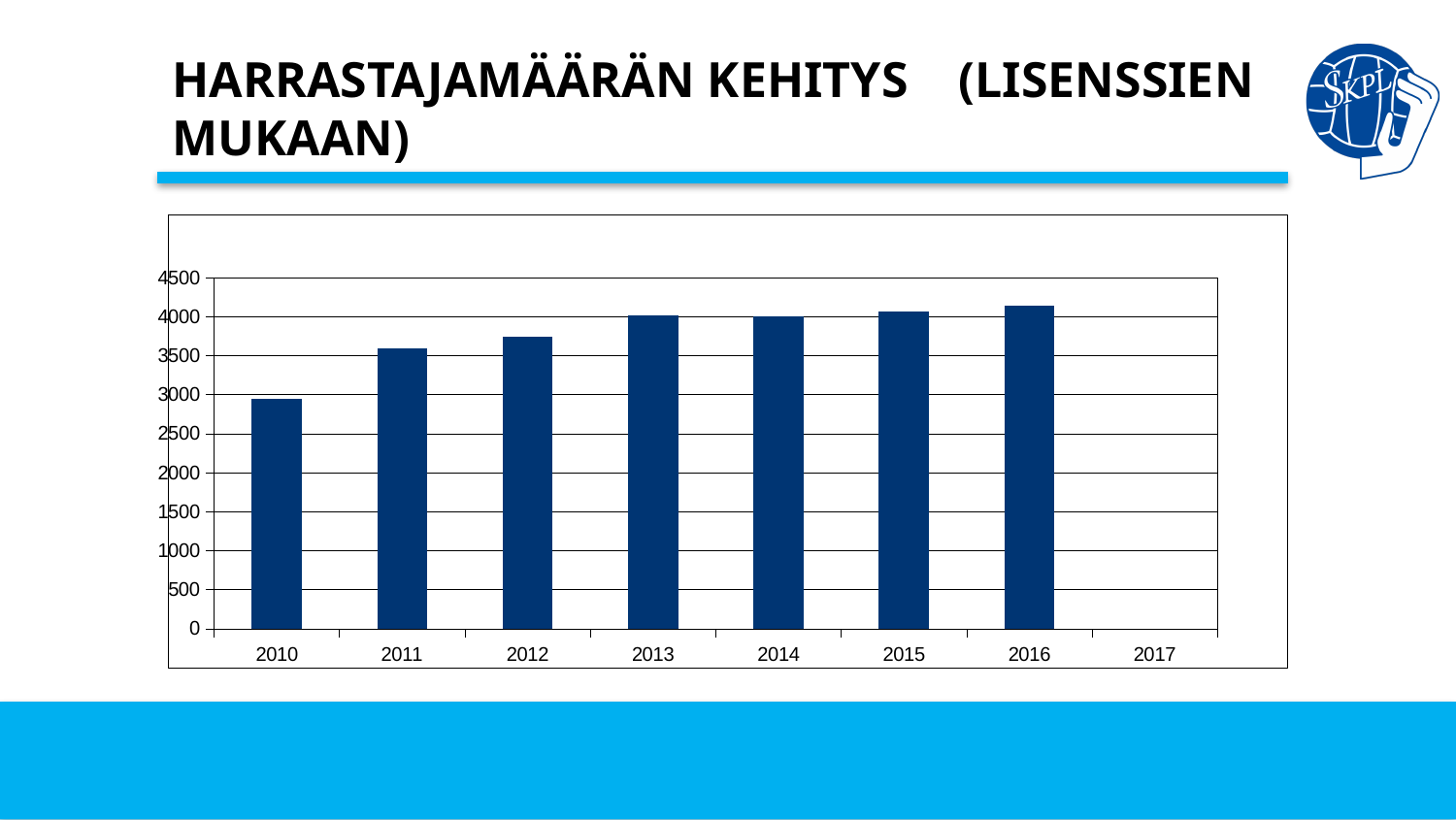
Is the value for 2010 greater or less than 2500? greater Which year on the x axis has no bar plotted? 2017 Is the value for 2012 greater or less than 4000? less Which is larger, the value for 2010 or the value for 2011? 2011 Which year has the lowest value in the chart? 2010 Is the value for 2011 greater or less than 3500? greater Do the values generally rise or fall from 2010 to 2016? rise Which is larger, the value for 2012 or the value for 2016? 2016 Which year has the highest value in the chart? 2016 What kind of chart is shown on the slide? bar chart How many years are labelled on the x axis? 8